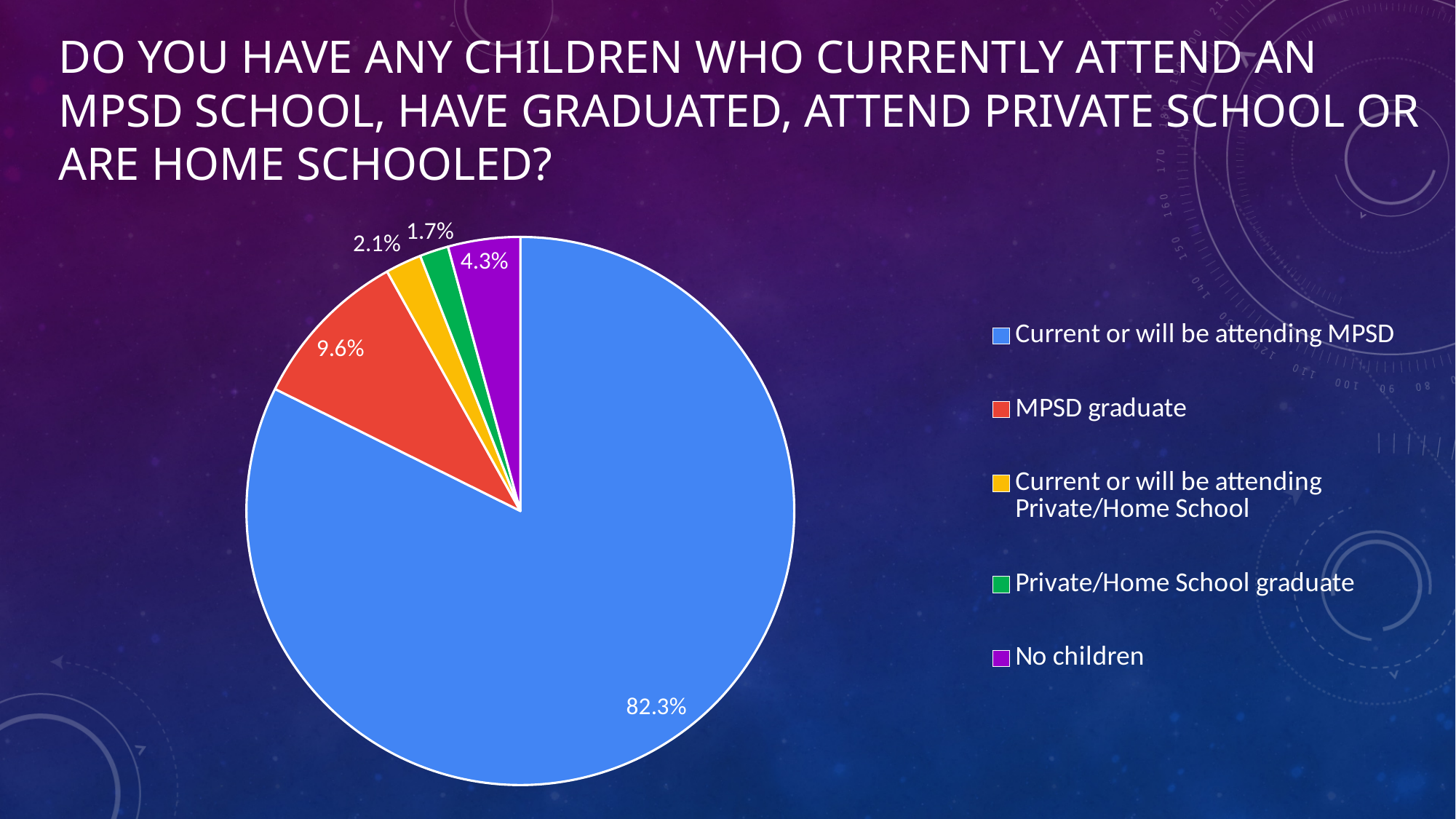
What colour is the slice for No children? Purple What percentage of respondents have children who are current or will be attending Private/Home School? 2.1% Which category has the smallest share of the pie? Private/Home School graduate What percentage of respondents have no children? 4.3% How many categories does the pie chart show? 5 What type of chart is shown on the slide? Pie chart What is the difference in percentage points between MPSD graduate and No children? 5.3 Which category has the largest share of the pie? Current or will be attending MPSD Which is larger: the share for No children or the share for MPSD graduate? MPSD graduate What percentage of respondents have children who are Private/Home School graduates? 1.7% What percentage of respondents have children who are MPSD graduates? 9.6% What percentage of respondents have children who are current or will be attending MPSD? 82.3%